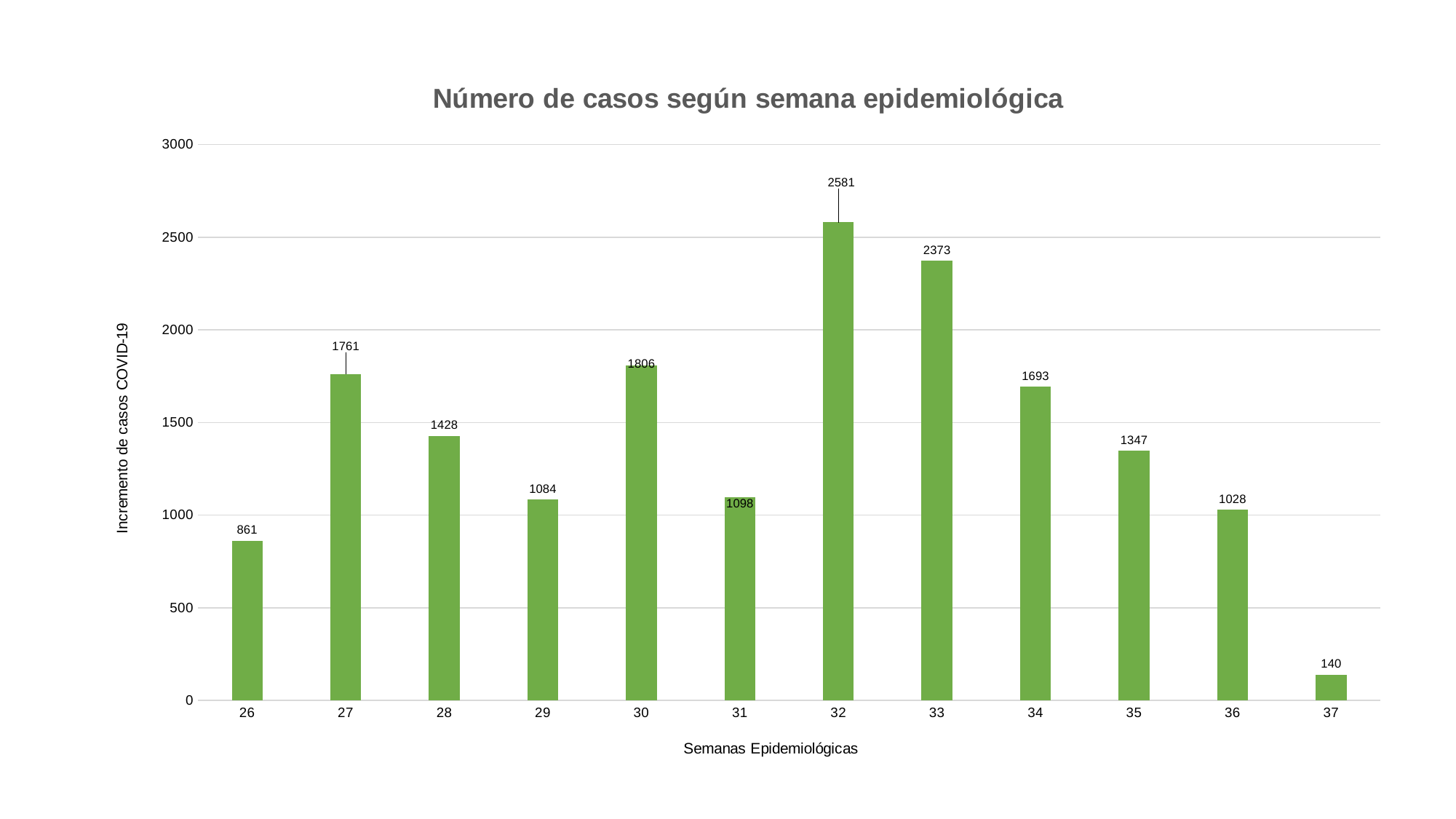
Is the value for week 35 greater or less than 1500? less What is the value for week 37? 140 What is the value for week 29? 1084 What kind of chart is this? bar chart What is the difference between the values for week 27 and week 26? 900 Which is larger, the value for week 30 or the value for week 34? week 30 What is the value for week 32? 2581 Which week has the highest number of cases? 32 How many weeks are shown on the x axis? 12 What is the title of the chart? Número de casos según semana epidemiológica What is the difference between the values for week 32 and week 33? 208 Which week has the lowest number of cases? 37